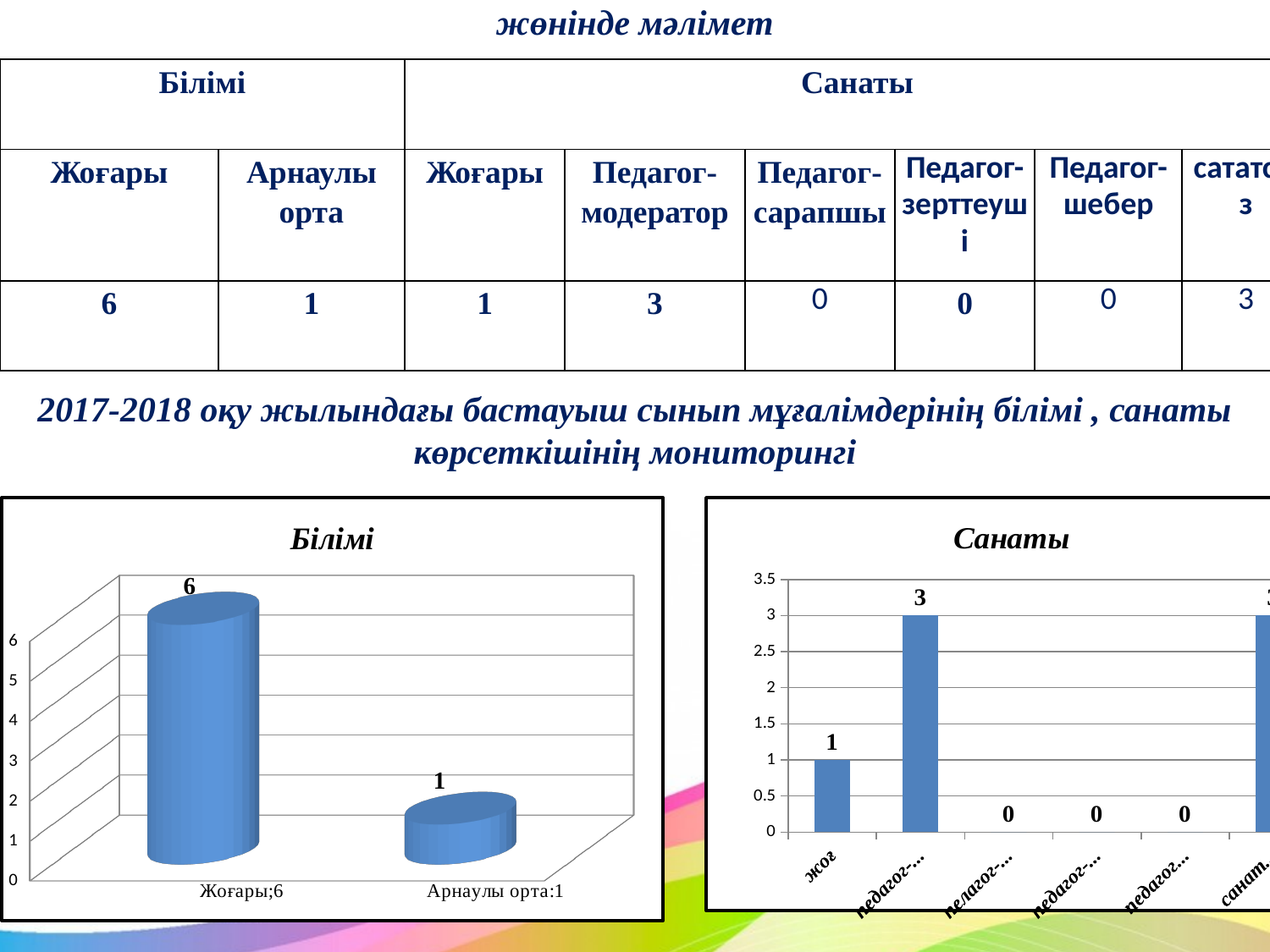
In the Санаты chart, what is the value of the second bar? 3 In the Білімі chart, what is the difference between the values for Жоғары and Арнаулы орта? 5 In the Білімі chart, which category has the lowest value? Арнаулы орта What is the title of the chart on the right side of the slide? Санаты In the Санаты chart, what is the value of the first bar (жоғ)? 1 In the Санаты chart, how many bars have a value of 0? 3 In the Білімі chart, which category has the highest value? Жоғары What kind of chart is the Білімі chart? bar chart In the Білімі chart, what is the value for Арнаулы орта? 1 In the Білімі chart, what is the value for Жоғары? 6 How many categories are shown in the Білімі chart? 2 In the Санаты chart, is the second bar's value greater or less than 2? greater